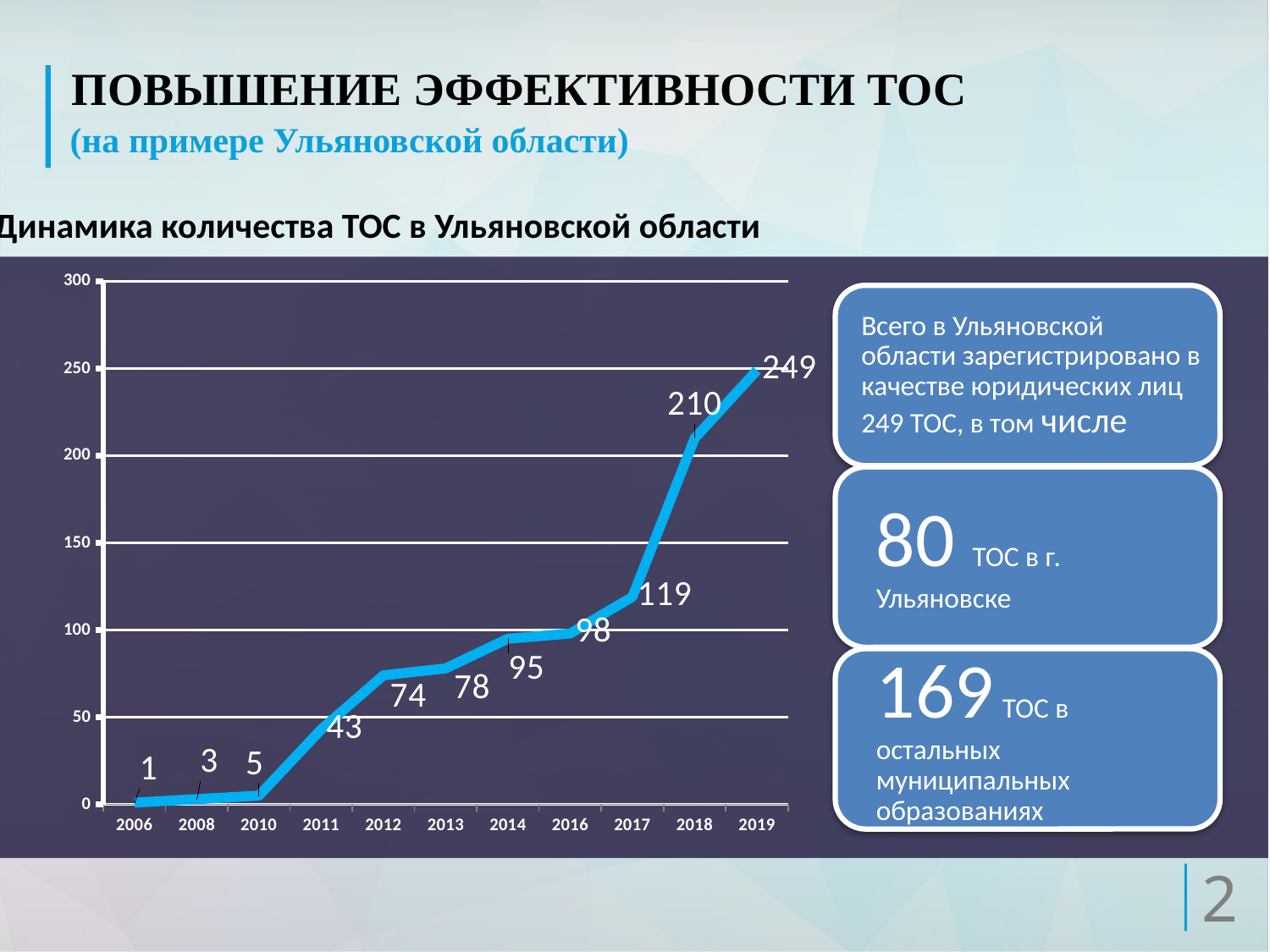
What is the value for 2017? 119 What is the value for 2012? 74 What is the value for 2006? 1 What is the difference between the values for 2019 and 2018? 39 Which year has the lowest value? 2006 Which is larger, the value for 2014 or the value for 2013? 2014 Do the values rise or fall from 2006 to 2019? rise How many years are plotted on the x axis? 11 What type of chart is shown on the slide? line chart Is the value for 2018 greater or less than 200? greater What is the difference between the values for 2011 and 2010? 38 Which year has the highest value? 2019